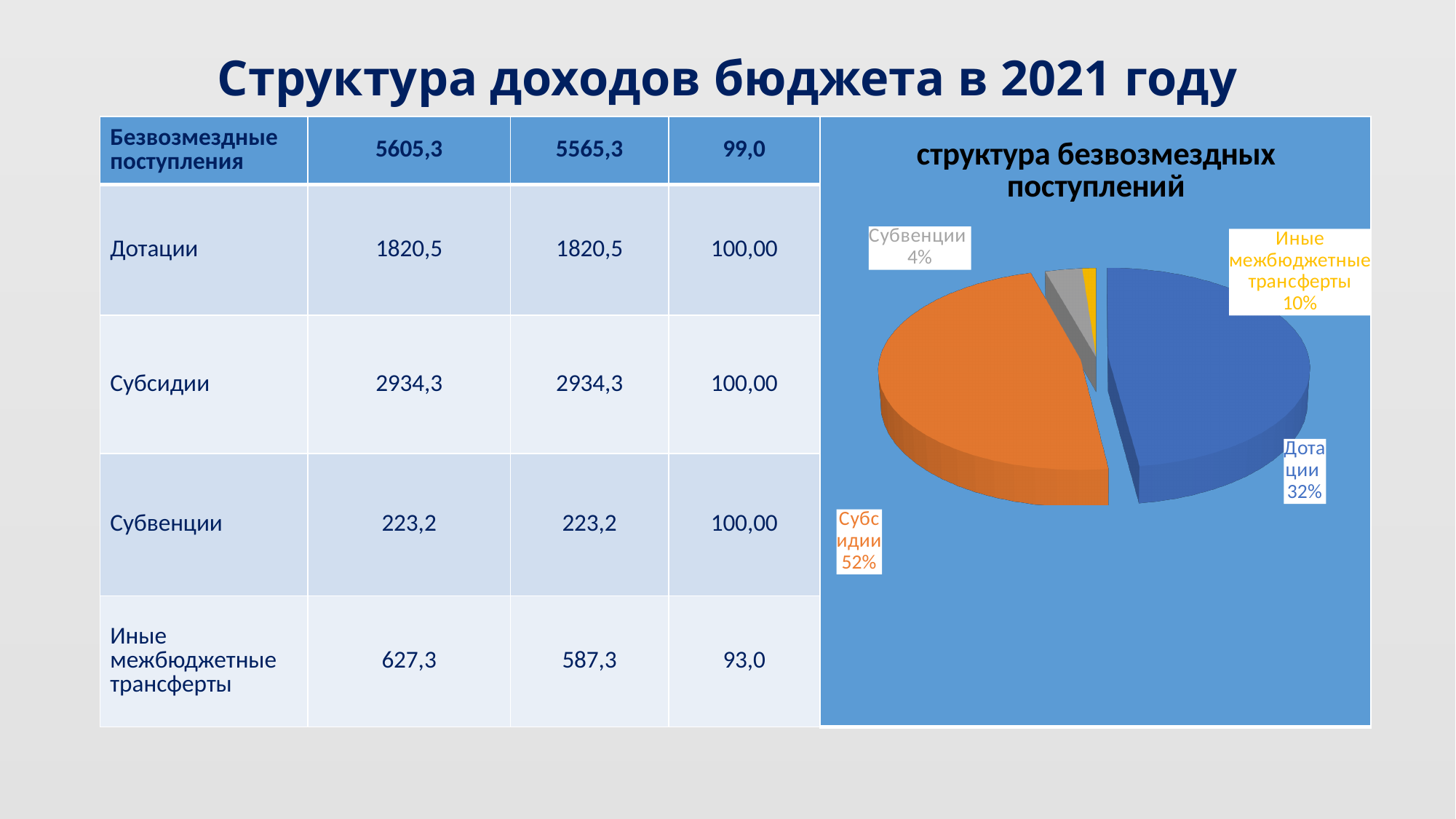
How many slices does the pie chart have? 4 What colour is the Субсидии slice in the pie chart? orange What share of the pie does Субвенции account for? 4% What is the title of the pie chart? структура безвозмездных поступлений By how many percentage points does the Субсидии share exceed the Дотации share? 20 What share of the pie does Дотации account for? 32% What share of the pie does Субсидии account for? 52% What kind of chart is shown on the slide? pie chart Which slice of the pie chart is the largest? Субсидии